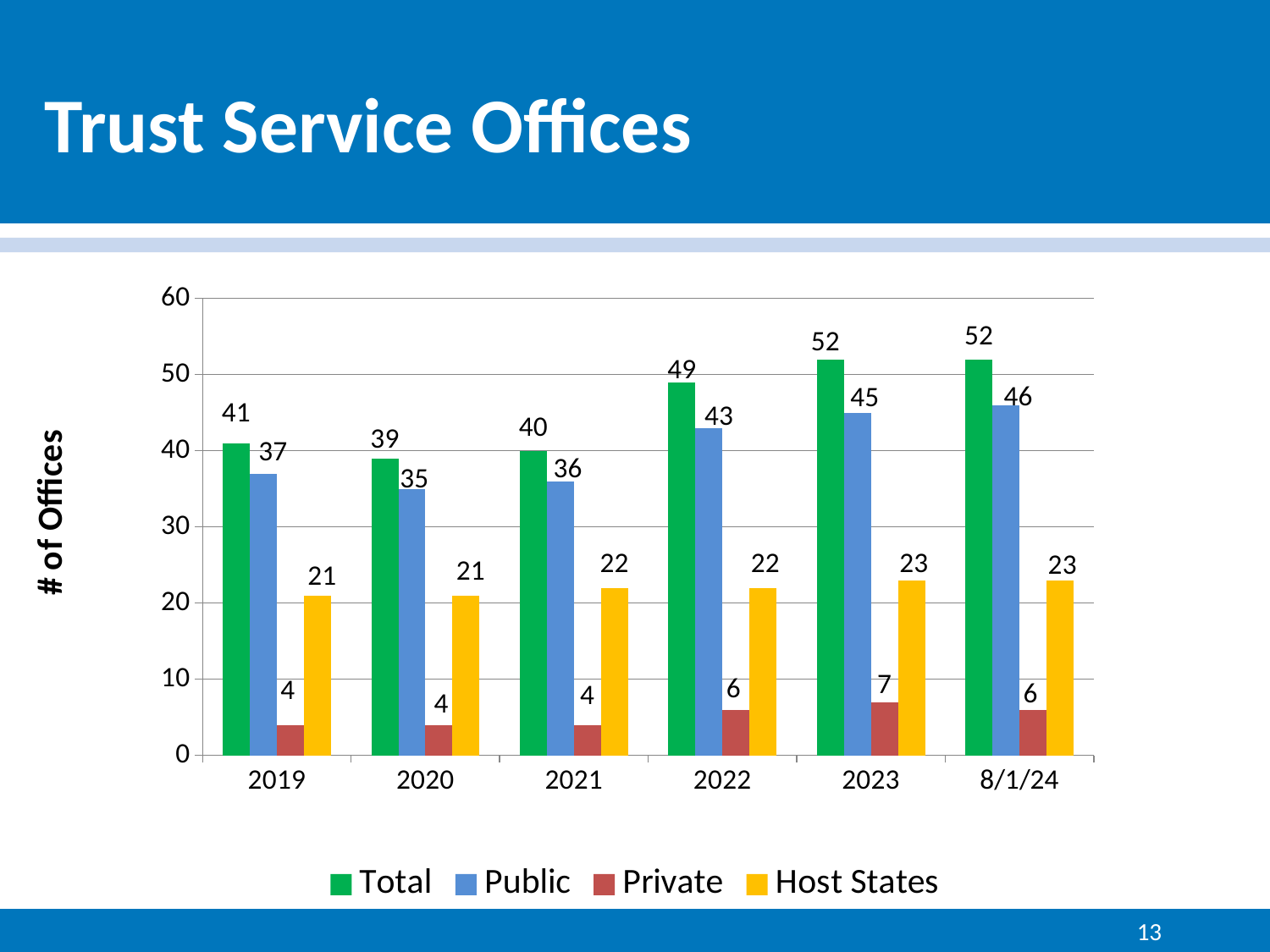
What is the difference between the Total and Public values for 2019? 4 Which is larger, the Host States value for 2021 or the Host States value for 2023? 2023 Which year has the lowest Total value? 2020 What kind of chart is shown on the slide? bar chart Is the Total value for 2023 greater or less than 50? greater What is the Private value for 2023? 7 What is the Total value for 2022? 49 How many categories are shown on the x axis? 6 What is the Public value for 2020? 35 What is the Host States value for 8/1/24? 23 How many series does the legend list? 4 Which category has the highest Public value? 8/1/24